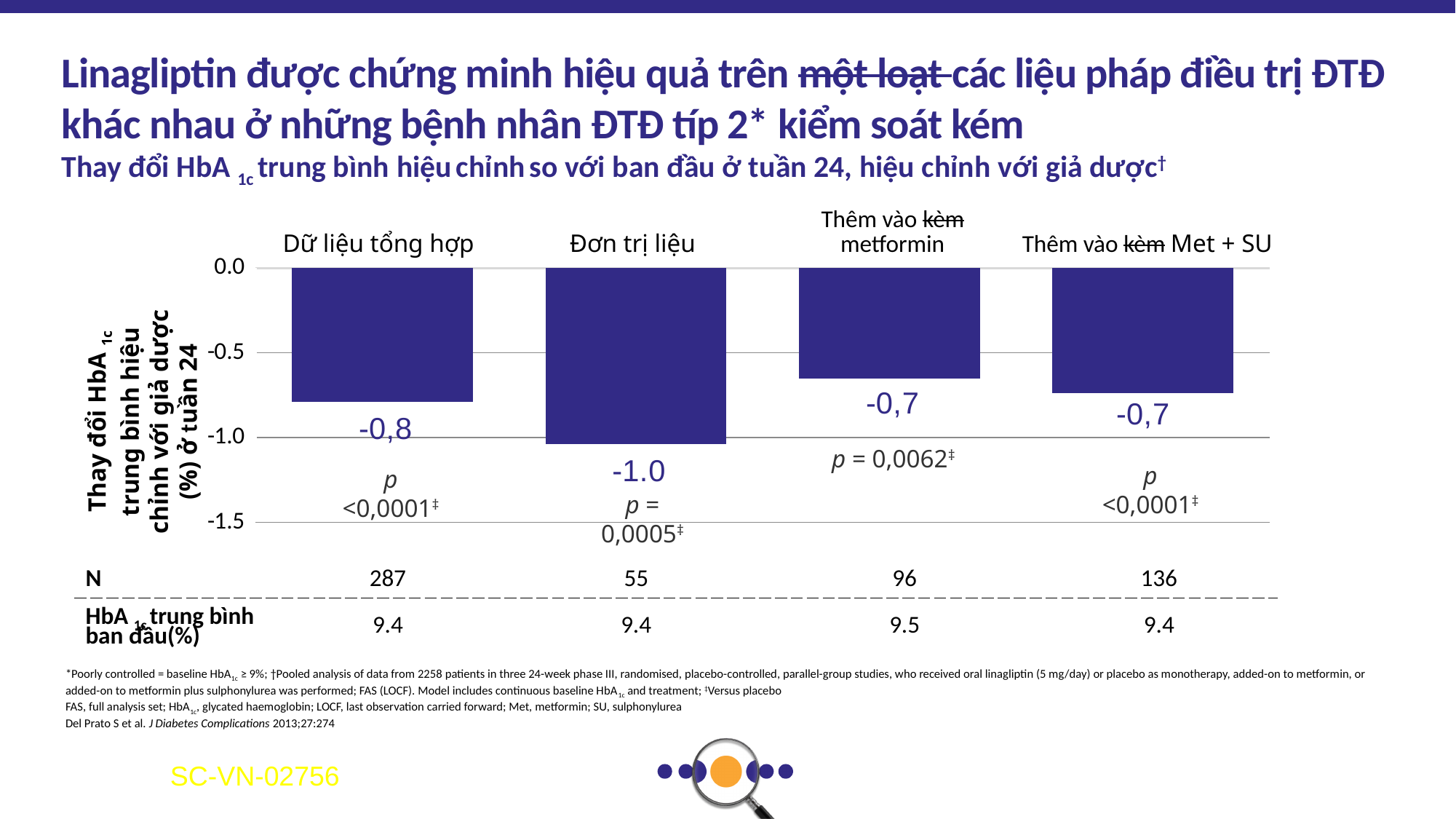
What is the difference between the values for Dữ liệu tổng hợp and Đơn trị liệu? 0.2 What is the N value listed under Đơn trị liệu? 55 What is the difference between the values for Đơn trị liệu and Thêm vào kèm metformin? 0.3 What kind of chart is shown on the slide? bar chart What is the value shown for Thêm vào kèm Met + SU? -0,7 Which shows a larger reduction in HbA1c, Dữ liệu tổng hợp or Thêm vào kèm metformin? Dữ liệu tổng hợp How many categories are plotted in the chart? 4 What is the value shown for Đơn trị liệu? -1.0 What is the value shown for Thêm vào kèm metformin? -0,7 Is the value for Đơn trị liệu greater or less than -0.5? less What is the value shown for Dữ liệu tổng hợp? -0,8 Which category shows the largest reduction in HbA1c (the most negative value)? Đơn trị liệu